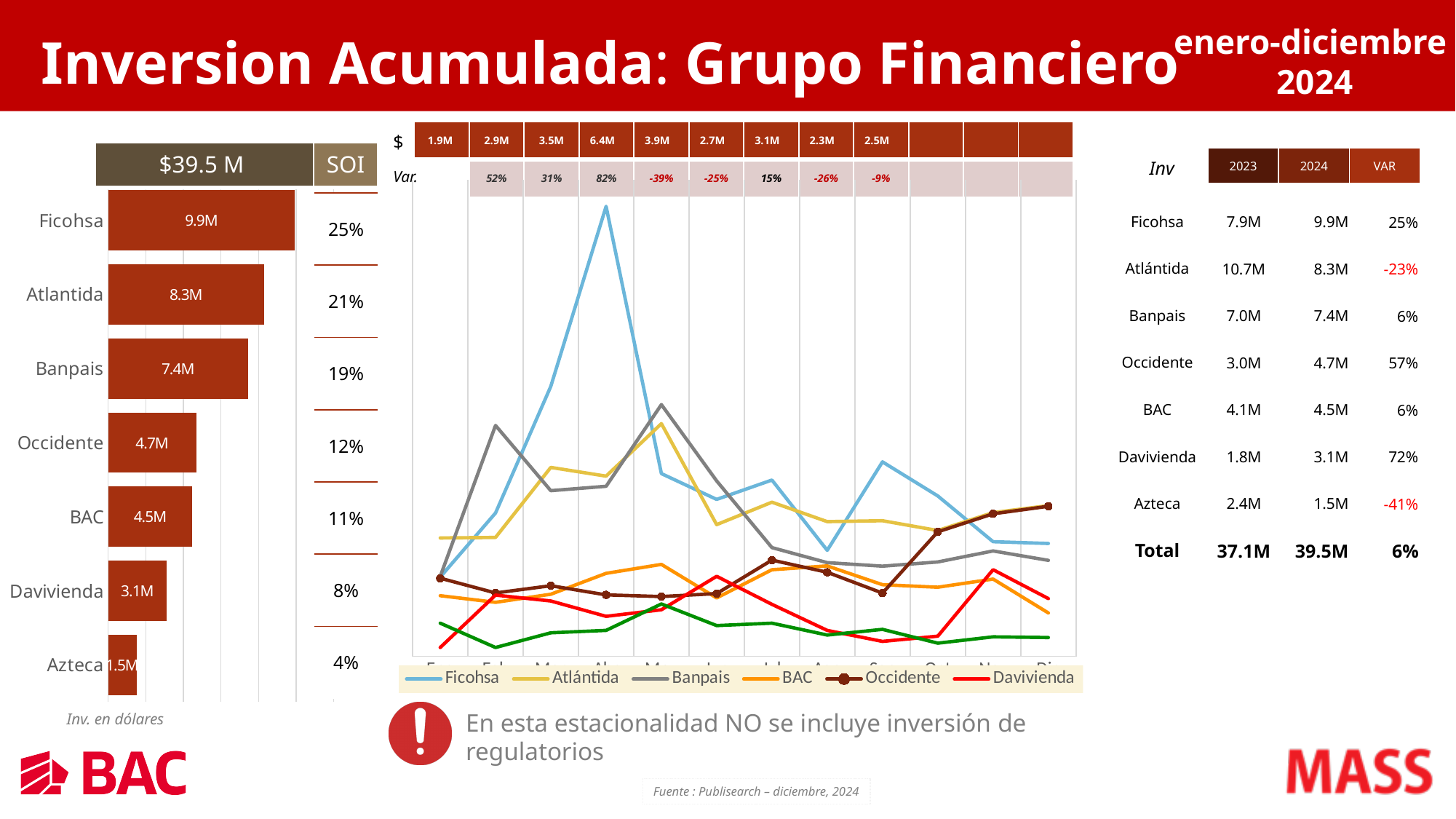
What kind of chart is the chart on the left of the slide? Bar chart What kind of chart is the chart in the middle of the slide? Line chart In the bar chart on the left, what is the difference between the values for Ficohsa and Atlantida? 1.6M How many banks are shown in the bar chart on the left? 7 In the bar chart on the left, what is the value for Ficohsa? 9.9M In the middle line chart, in which month does the Ficohsa line reach its peak? April (Abr) In the bar chart on the left, which is larger, the value for Banpais or the value for Occidente? Banpais In the bar chart on the left, which bank has the lowest accumulated investment? Azteca How many series does the legend of the middle line chart list? 6 In the bar chart on the left, what is the value for Davivienda? 3.1M In the bar chart on the left, what SOI percentage is shown for Occidente? 12% In the bar chart on the left, which bank has the highest accumulated investment? Ficohsa